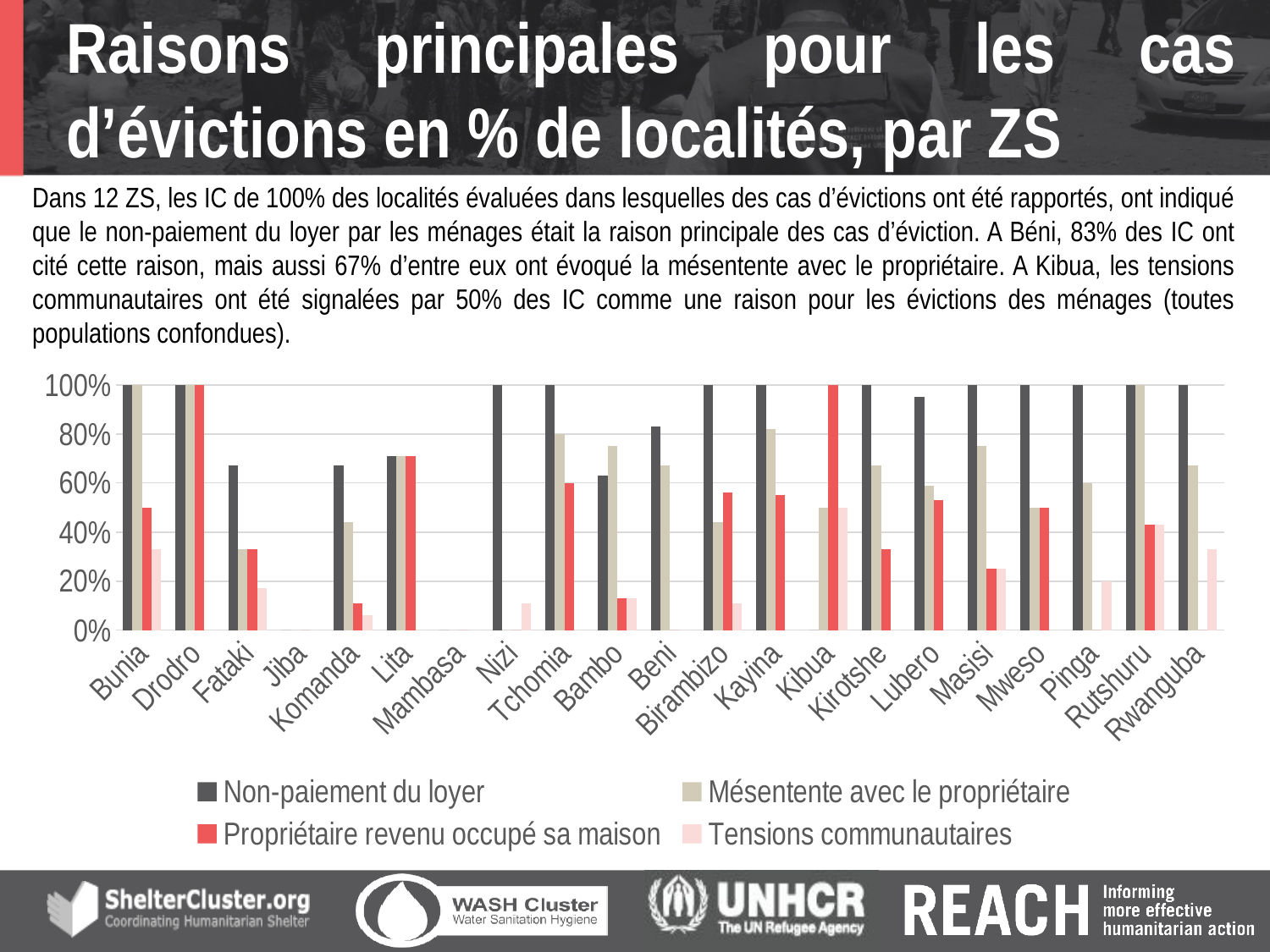
How many series does the legend list? 4 Is the value of 'Mésentente avec le propriétaire' for Kayina greater or less than 60%? greater What is the value of 'Propriétaire revenu occupé sa maison' for Kibua? 100% Is the value of 'Tensions communautaires' for Kibua greater or less than 20%? greater Which colour represents 'Non-paiement du loyer' in the legend? dark grey Is the value of 'Non-paiement du loyer' for Fataki greater or less than 80%? less For Kibua, which is larger: 'Propriétaire revenu occupé sa maison' or 'Mésentente avec le propriétaire'? Propriétaire revenu occupé sa maison For Bunia, which is larger: 'Non-paiement du loyer' or 'Propriétaire revenu occupé sa maison'? Non-paiement du loyer What kind of chart is shown on the slide? bar chart What is the value of 'Mésentente avec le propriétaire' for Drodro? 100% How many ZS (categories) are shown along the x axis? 21 What is the value of 'Non-paiement du loyer' for Bunia? 100%